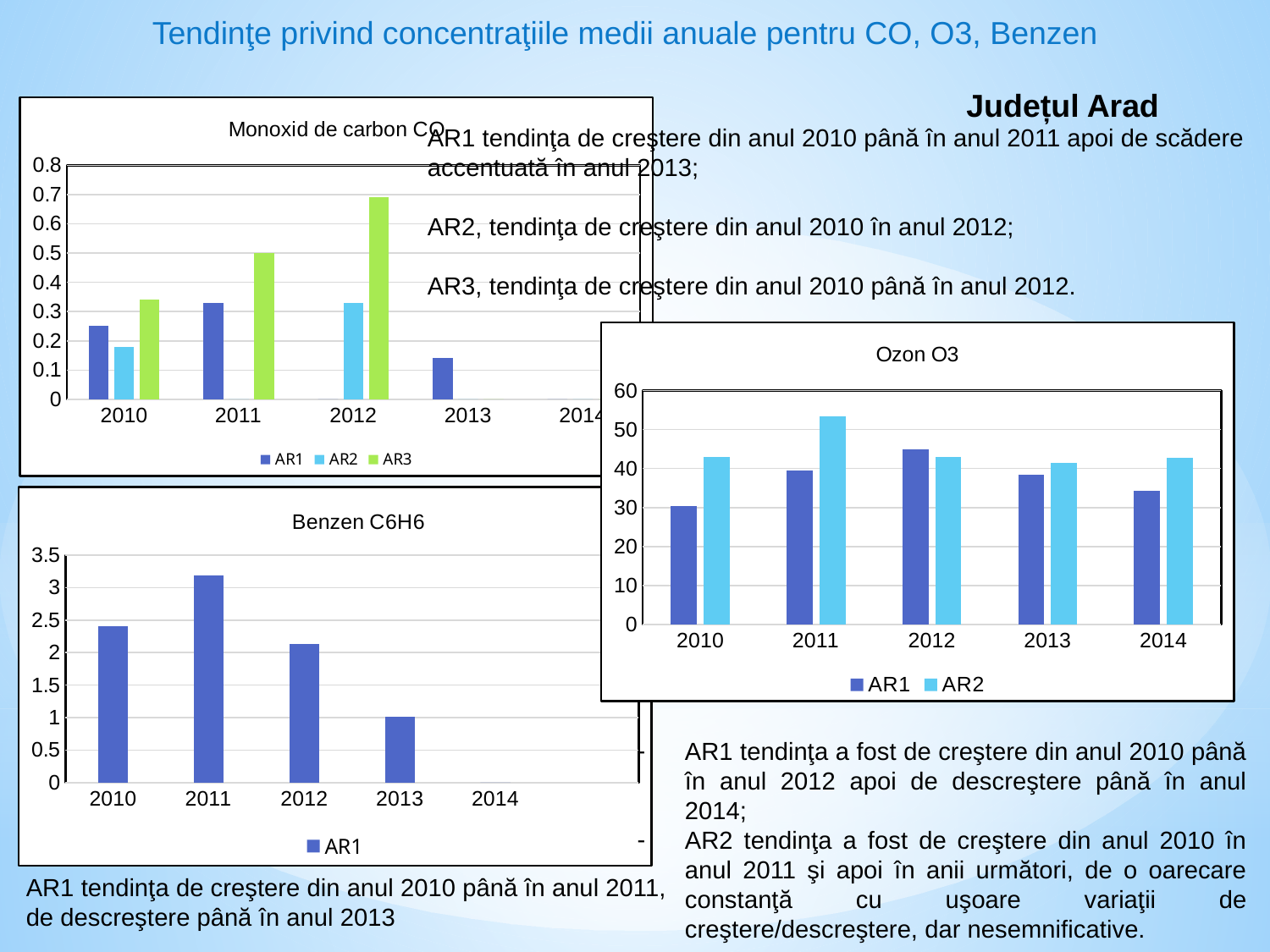
In the "Monoxid de carbon CO" chart, is the AR1 value for 2013 greater or less than 0.2? less In the "Ozon O3" chart, which is larger in 2011: AR1 or AR2? AR2 In the "Benzen C6H6" chart, do the AR1 values rise or fall from 2011 to 2013? fall In the "Ozon O3" chart, is the AR1 value for 2010 greater or less than 40? less In the "Monoxid de carbon CO" chart, which is larger in 2010: AR1 or AR3? AR3 How many series does the legend of the "Ozon O3" chart list? 2 In the "Monoxid de carbon CO" chart, is the AR3 value for 2011 greater or less than 0.4? greater In the "Monoxid de carbon CO" chart, which year has the highest AR3 value? 2012 What kind of chart is the "Monoxid de carbon CO" chart? bar chart In the "Benzen C6H6" chart, which year has the highest AR1 value? 2011 In the "Ozon O3" chart, which year has the highest AR2 value? 2011 How many series does the legend of the "Monoxid de carbon CO" chart list? 3